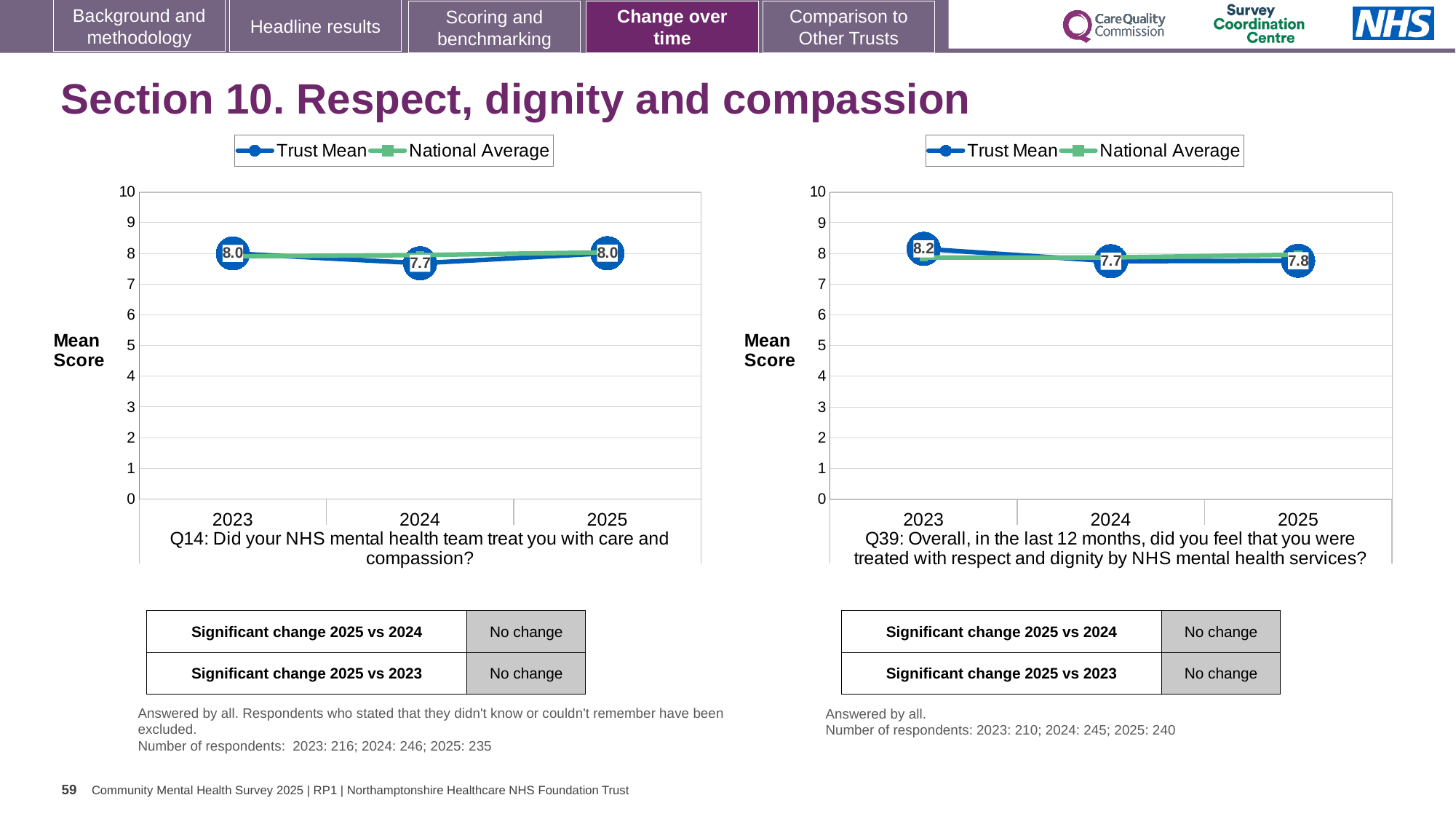
How many years are plotted on the x axis of the left chart (Q14)? 3 On the left chart (Q14), in which year is the Trust Mean lowest? 2024 On the right chart (Q39), is the National Average value for 2025 greater or less than 5? greater On the left chart (Q14), what is the Trust Mean score for 2025? 8.0 On the left chart (Q14), what is the Trust Mean score for 2024? 7.7 On the right chart (Q39), what is the Trust Mean score for 2025? 7.8 On the left chart (Q14), is the Trust Mean for 2023 larger or smaller than the Trust Mean for 2024? larger On the right chart (Q39), what is the difference between the Trust Mean in 2023 and in 2024? 0.5 On the right chart (Q39), in which year is the Trust Mean highest? 2023 How many series does the legend of the right chart (Q39) list? 2 On the right chart (Q39), what is the Trust Mean score for 2023? 8.2 What kind of chart is the left chart (Q14)? line chart